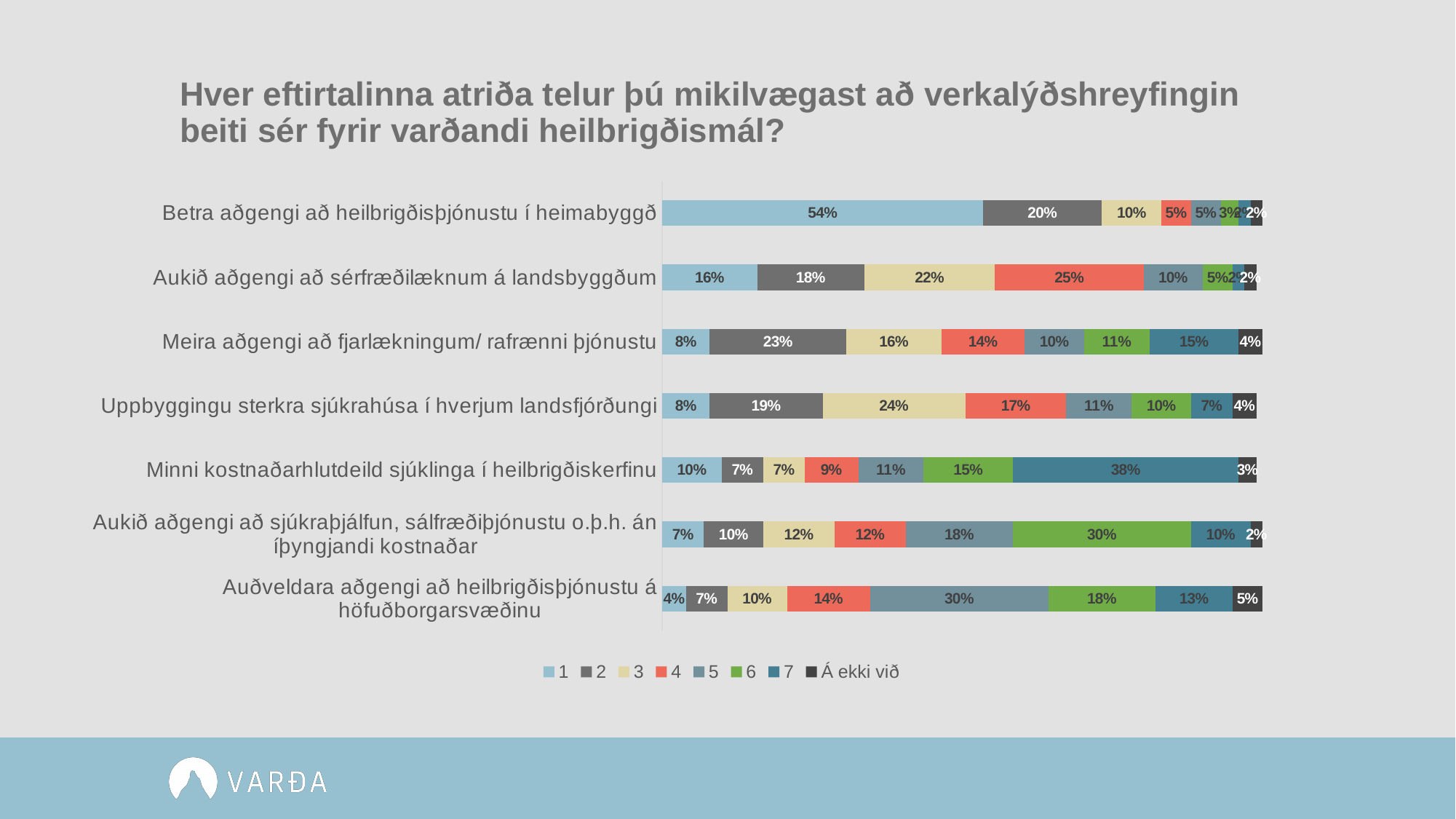
What is the difference between the series 2 value for "Meira aðgengi að fjarlækningum/ rafrænni þjónustu" and the series 2 value for "Uppbyggingu sterkra sjúkrahúsa í hverjum landsfjórðungi"? 4% What is the value for series 7 in the "Minni kostnaðarhlutdeild sjúklinga í heilbrigðiskerfinu" bar? 38% What is the last entry in the chart's legend? Á ekki við What kind of chart is shown on the slide? Stacked bar chart How many series does the legend list? 8 Which is larger: the series 5 value for "Auðveldara aðgengi að heilbrigðisþjónustu á höfuðborgarsvæðinu" or the series 5 value for "Minni kostnaðarhlutdeild sjúklinga í heilbrigðiskerfinu"? Auðveldara aðgengi að heilbrigðisþjónustu á höfuðborgarsvæðinu What is the value for series 6 in the "Aukið aðgengi að sjúkraþjálfun, sálfræðiþjónustu o.þ.h. án íþyngjandi kostnaðar" bar? 30% How many categories are shown in the chart? 7 Which category has the lowest value for series 1? Auðveldara aðgengi að heilbrigðisþjónustu á höfuðborgarsvæðinu Which category has the highest value for series 1? Betra aðgengi að heilbrigðisþjónustu í heimabyggð What is the value for series 4 in the "Aukið aðgengi að sérfræðilæknum á landsbyggðum" bar? 25% What percentage of respondents ranked "Betra aðgengi að heilbrigðisþjónustu í heimabyggð" as 1? 54%